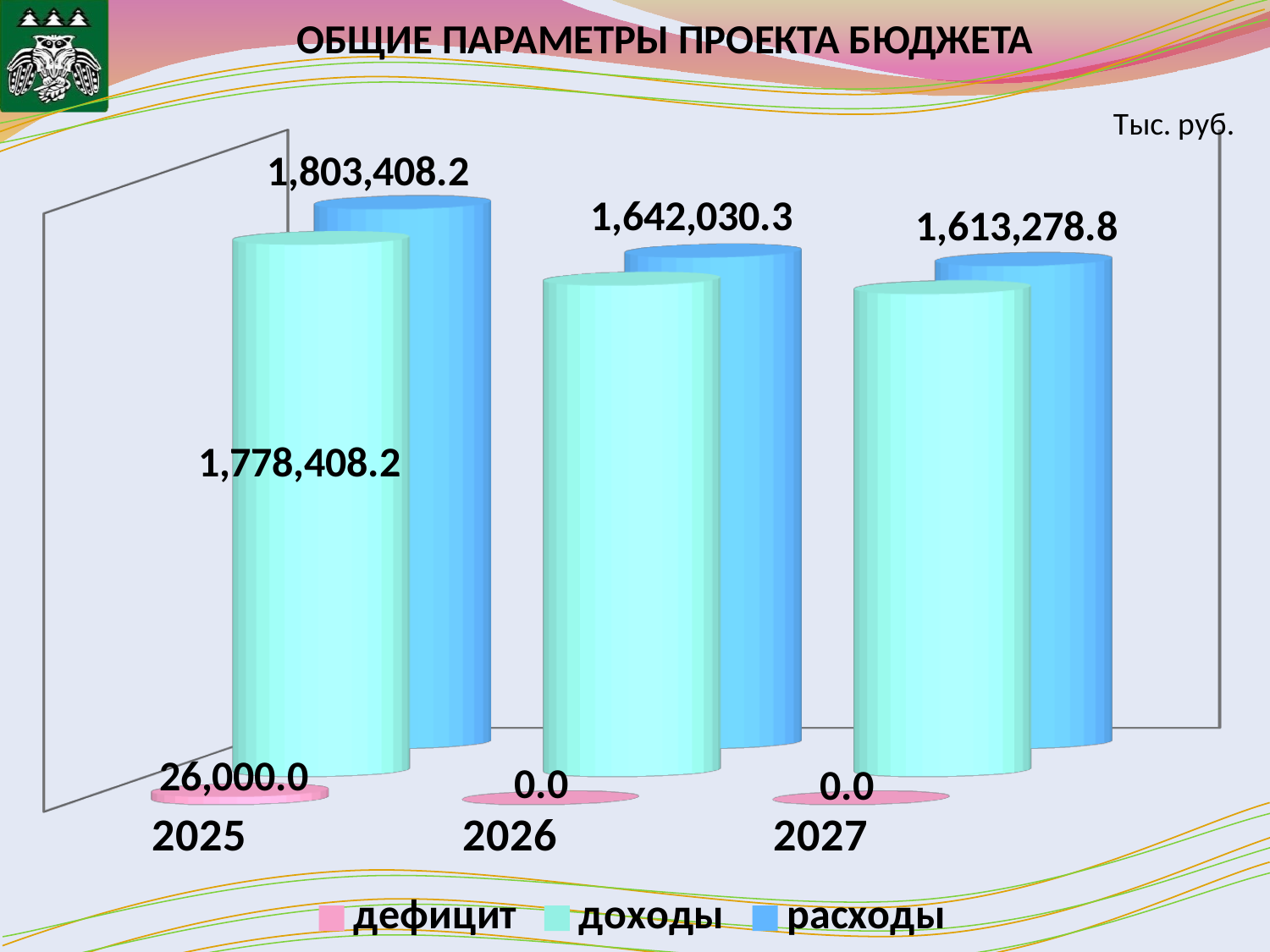
What is the value of доходы for 2025? 1,778,408.2 What unit of measurement is shown on the slide for the chart values? Тыс. руб. What is the value of дефицит for 2025? 26,000.0 What is the difference between расходы and доходы in 2025? 25,000.0 Which year has the highest расходы? 2025 How many series does the legend list? 3 Do the расходы values rise or fall from 2025 to 2027? fall What is the value of дефицит for 2027? 0.0 Which year has the lowest расходы? 2027 What is the value of расходы for 2027? 1,613,278.8 What is the value of расходы for 2026? 1,642,030.3 What is the value of расходы for 2025? 1,803,408.2